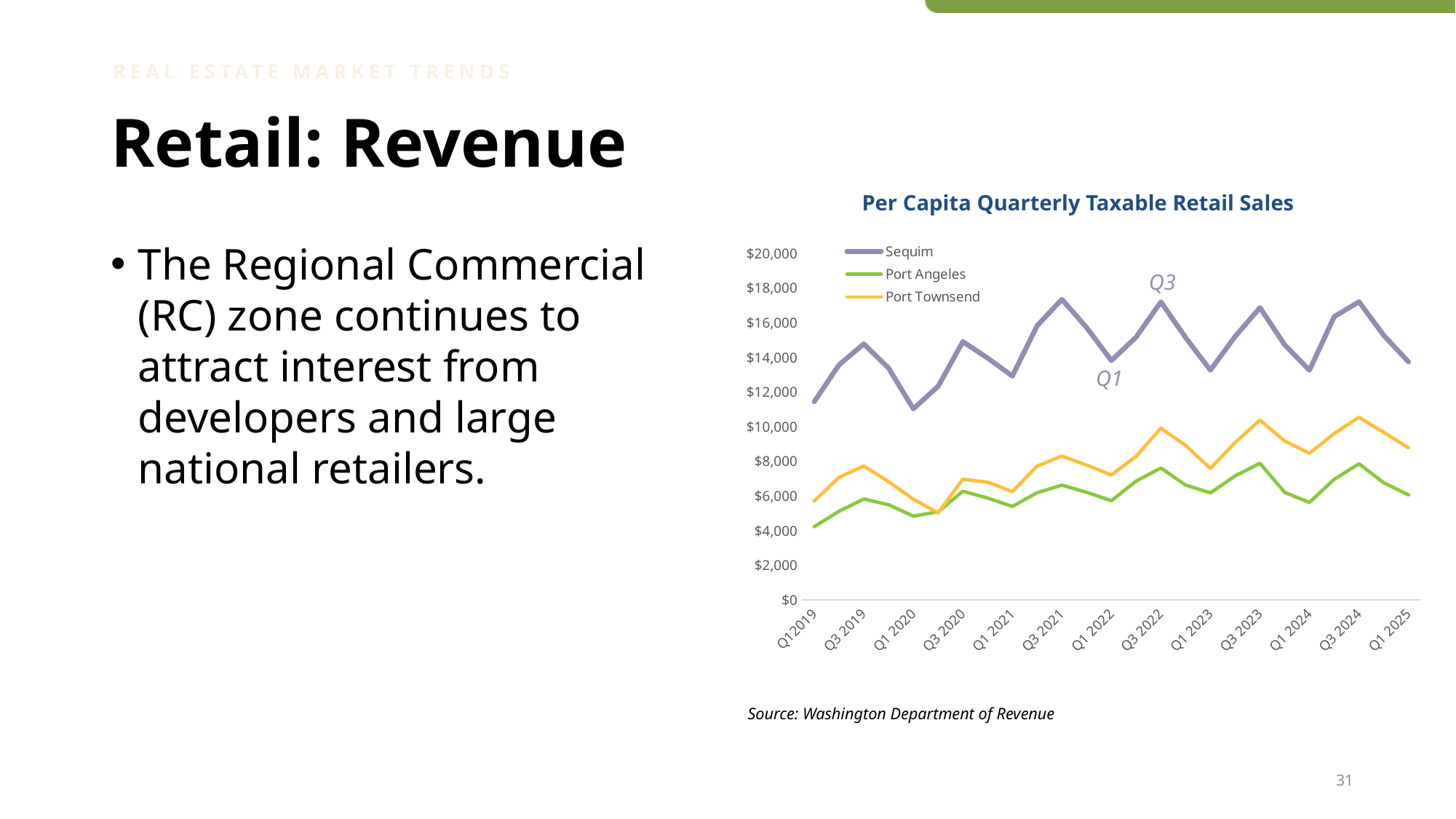
Is the value for Sequim at Q3 2021 greater or less than $16,000? greater Is the value for Sequim at Q1 2019 greater or less than $10,000? greater Is the value for Port Angeles at Q1 2019 greater or less than $6,000? less What is the title of the chart? Per Capita Quarterly Taxable Retail Sales Does the Port Townsend line rise or fall overall from Q1 2019 to Q1 2025? Rise How many series does the chart's legend list? 3 Which series has the highest values throughout the chart? Sequim At Q1 2025, which is larger: the value for Port Townsend or the value for Port Angeles? Port Townsend What kind of chart is shown on the slide? Line chart What source is cited below the chart? Washington Department of Revenue